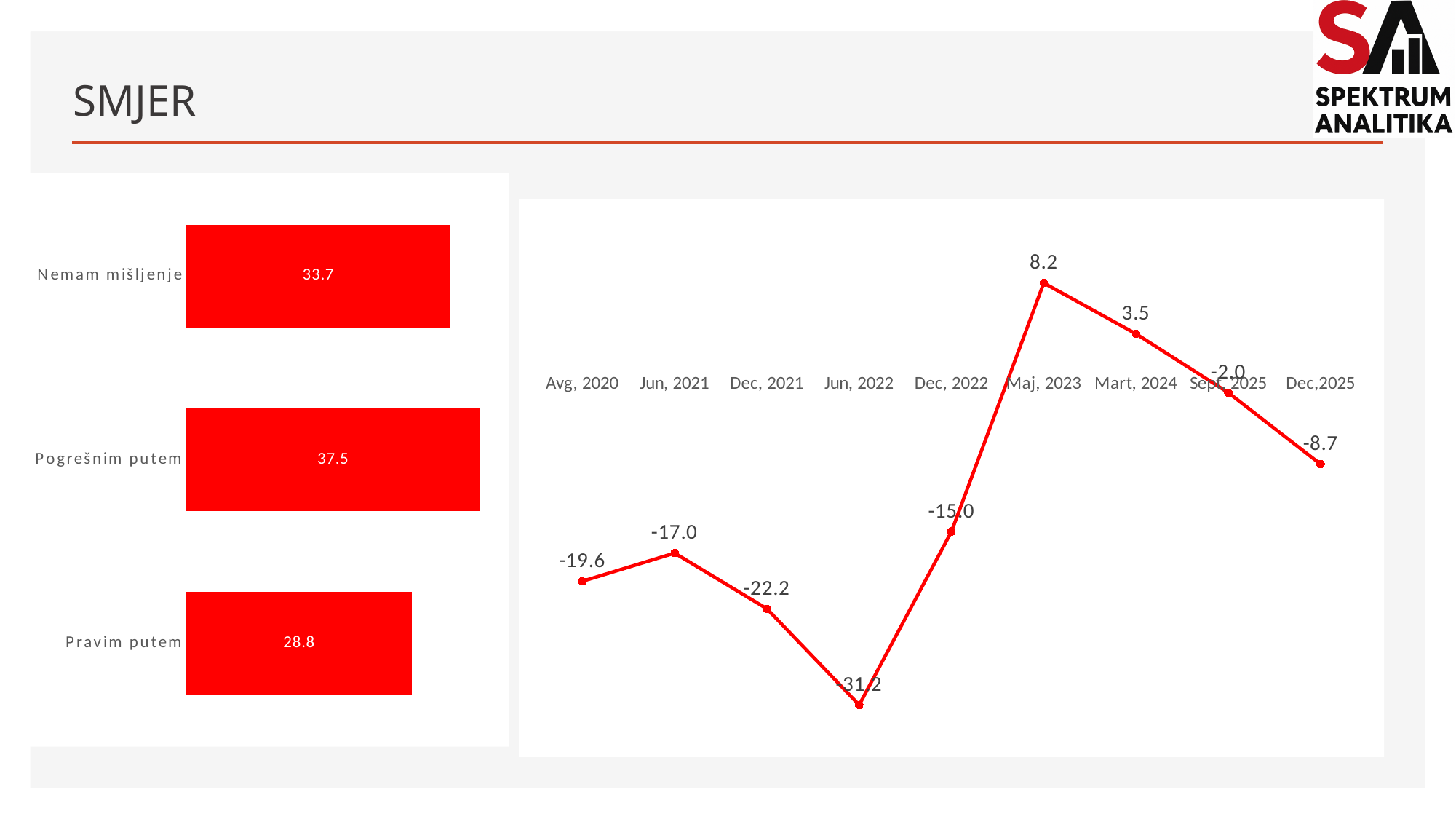
In the bar chart on the left, how many categories are shown? 3 In the bar chart on the left, which category has the highest value? Pogrešnim putem In the bar chart on the left, which category has the lowest value? Pravim putem In the line chart on the right, what is the value for Maj, 2023? 8.2 In the bar chart on the left, what is the difference between Pogrešnim putem and Pravim putem? 8.7 In the line chart on the right, do the values rise or fall from Maj, 2023 to Dec,2025? Fall In the bar chart on the left, what is the value for Pravim putem? 28.8 In the line chart on the right, how many data points are plotted? 9 In the line chart on the right, what is the value for Jun, 2022? -31.2 What kind of chart is on the left side of the slide? Bar chart In the bar chart on the left, what is the value for Pogrešnim putem? 37.5 In the line chart on the right, which point has the lowest value? Jun, 2022